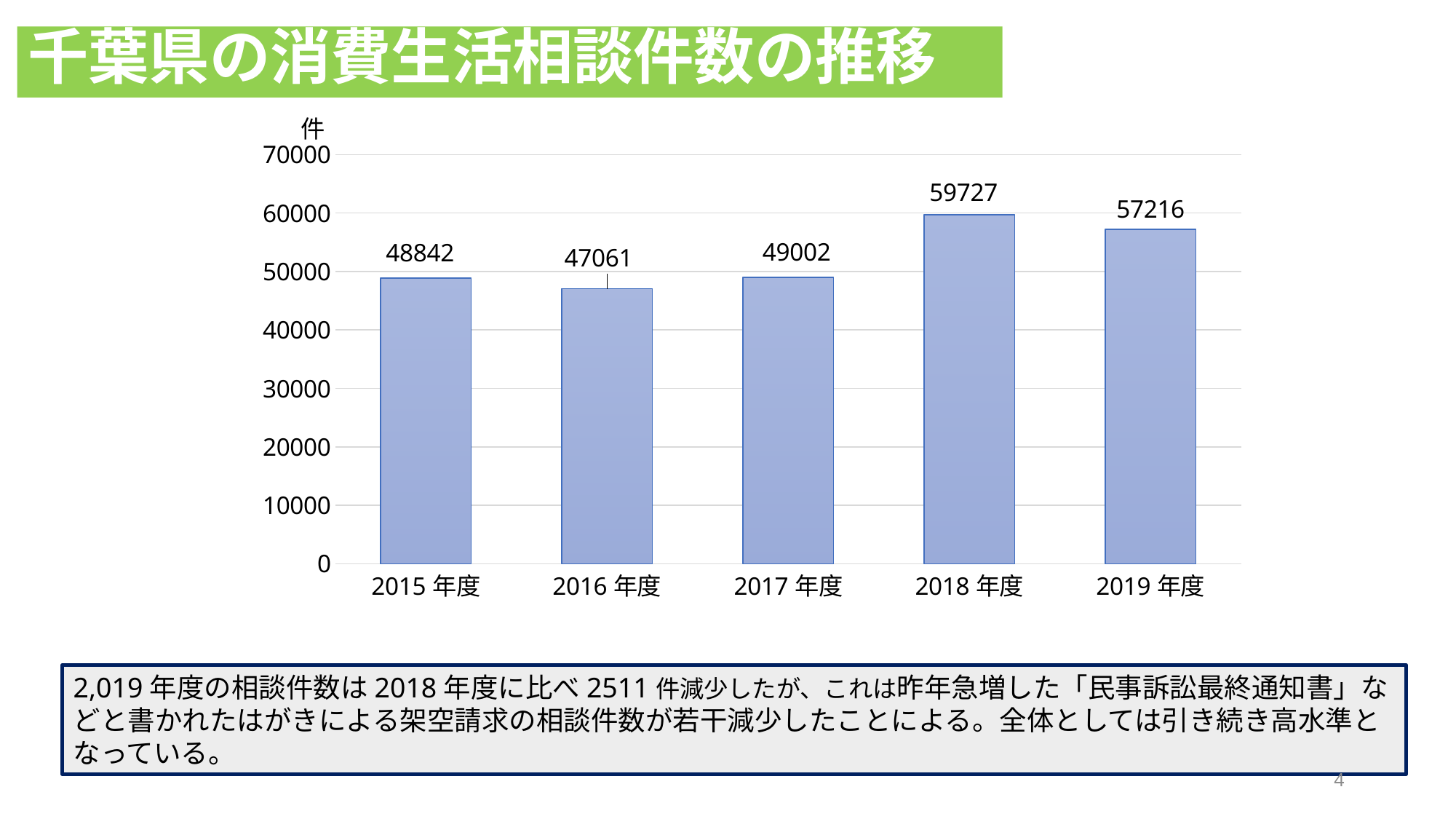
Which fiscal year has the lowest number of consultations? 2016年度 Which is larger, the value for 2015年度 or the value for 2019年度? 2019年度 Is the value for 2018年度 greater or less than 50000? greater What is the difference between the 2018年度 and 2019年度 values? 2511 What is the number of consultations for 2019年度? 57216 What is the number of consultations for 2015年度? 48842 What is the difference between the 2017年度 and 2016年度 values? 1941 What kind of chart is shown on the slide? bar chart What is the number of consultations for 2018年度? 59727 Which fiscal year has the highest number of consultations? 2018年度 How many fiscal years are shown on the x axis? 5 What is the title of the slide? 千葉県の消費生活相談件数の推移